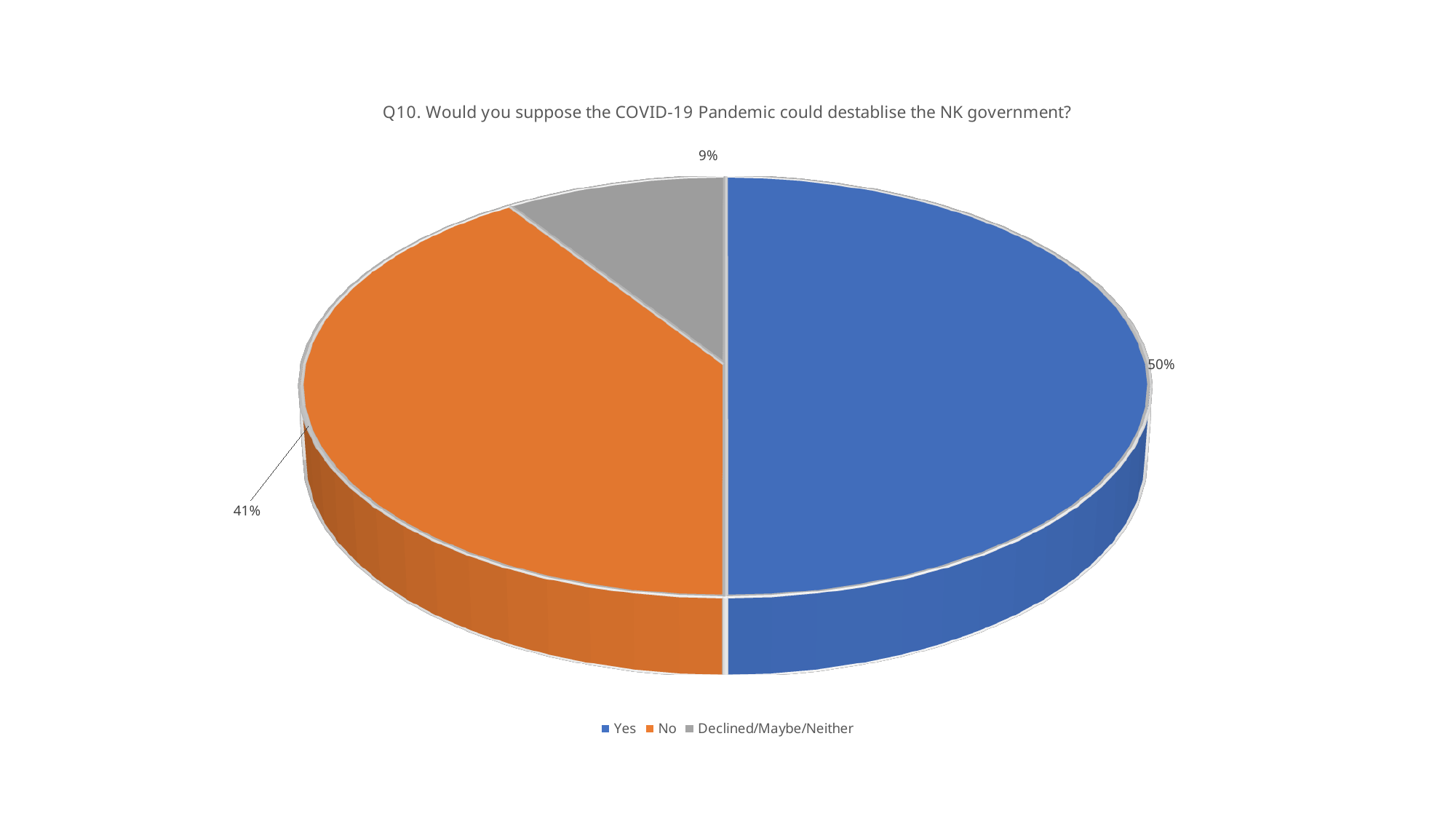
What colour is the No slice? Orange What is the difference in percentage points between the No and Declined/Maybe/Neither slices? 32 What is the title of the chart? Q10. Would you suppose the COVID-19 Pandemic could destablise the NK government? What percentage of respondents answered Yes? 50% What percentage of respondents answered No? 41% Which is larger, the Yes slice or the No slice? Yes What percentage of respondents are in the Declined/Maybe/Neither category? 9% Which response has the largest share of the pie? Yes Which response has the smallest share of the pie? Declined/Maybe/Neither What kind of chart is shown on the slide? Pie chart How many categories does the pie chart show? 3 What is the difference in percentage points between the Yes and No slices? 9